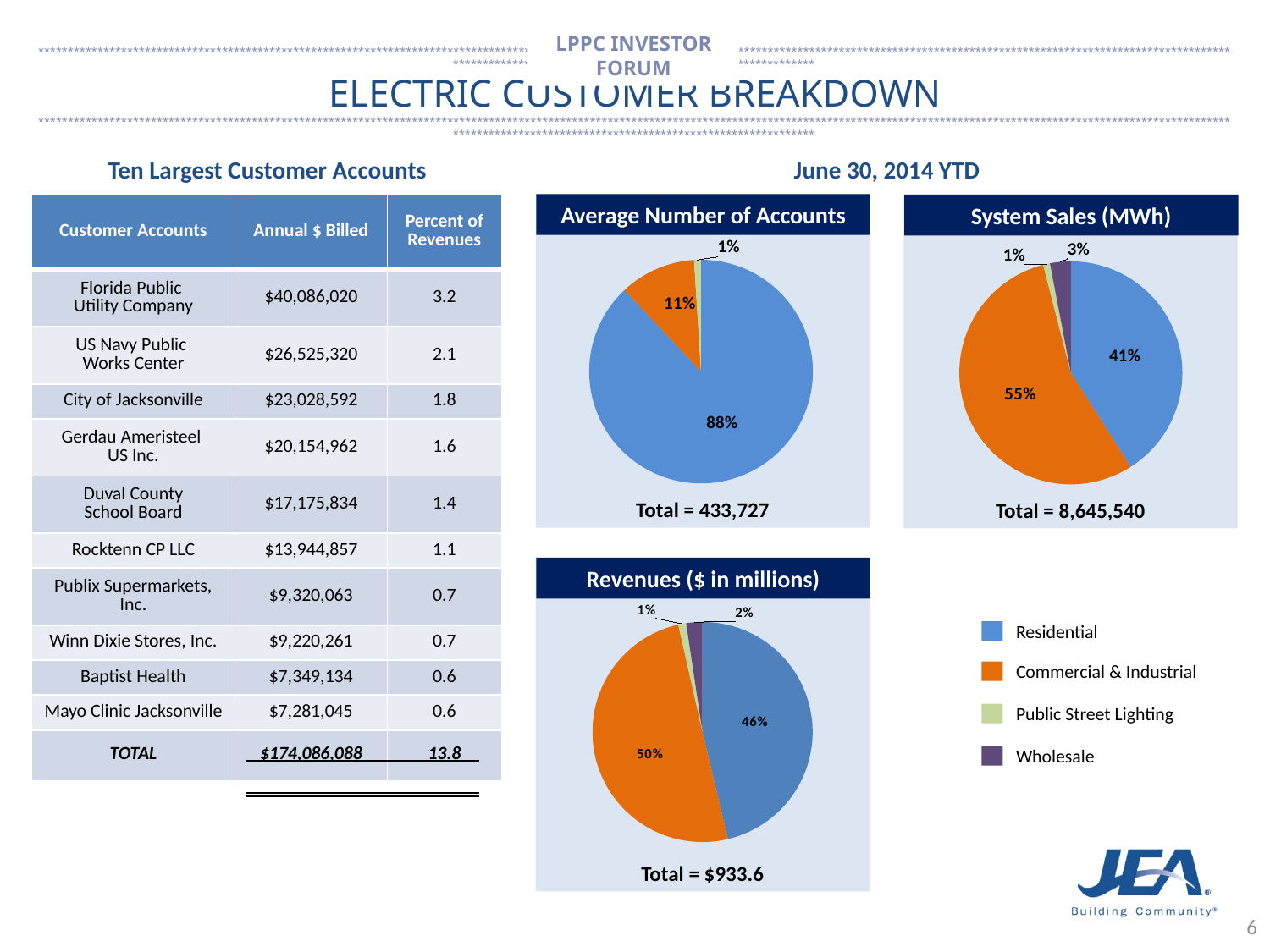
In the Average Number of Accounts chart, what share of accounts is Residential? 88% In the Average Number of Accounts chart, which category has the largest share? Residential In the Average Number of Accounts chart, what share of accounts is Commercial & Industrial? 11% What total is shown below the Revenues ($ in millions) chart? $933.6 What total is shown below the System Sales (MWh) chart? 8,645,540 In the Revenues ($ in millions) chart, what share of revenues is Residential? 46% In the System Sales (MWh) chart, what is the difference in percentage points between the Commercial & Industrial share and the Residential share? 14 In the Revenues ($ in millions) chart, which is larger, the Residential share or the Commercial & Industrial share? Commercial & Industrial What kind of chart is the Average Number of Accounts chart? Pie chart In the Revenues ($ in millions) chart, which category has the largest share? Commercial & Industrial In the System Sales (MWh) chart, what share of sales is Commercial & Industrial? 55% In the System Sales (MWh) chart, what share of sales is Wholesale? 3%